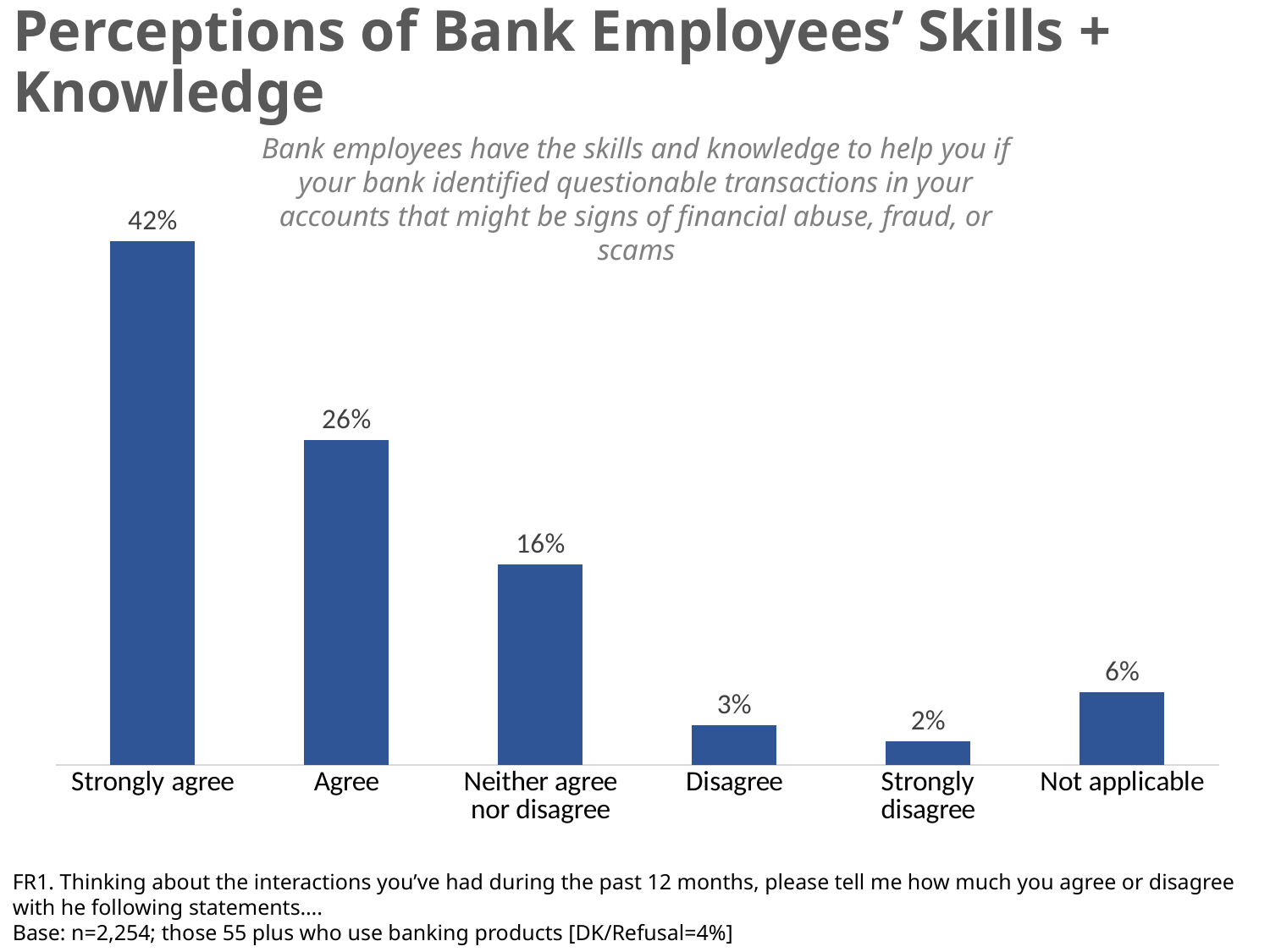
Which category has the highest value? Strongly agree What is the difference between the Disagree and Strongly disagree values? 1% Which is larger, the value for Not applicable or the value for Disagree? Not applicable What is the difference between the Strongly agree and Agree values? 16% How many categories are shown on the x axis? 6 What percentage of respondents neither agree nor disagree? 16% Which category has the lowest value? Strongly disagree What percentage of respondents strongly agree that bank employees have the skills and knowledge to help them? 42% What is the sample size (n) stated in the base note below the chart? 2,254 What is the value shown for the Agree category? 26% What kind of chart is shown on the slide? Bar chart What is the value shown for Not applicable? 6%